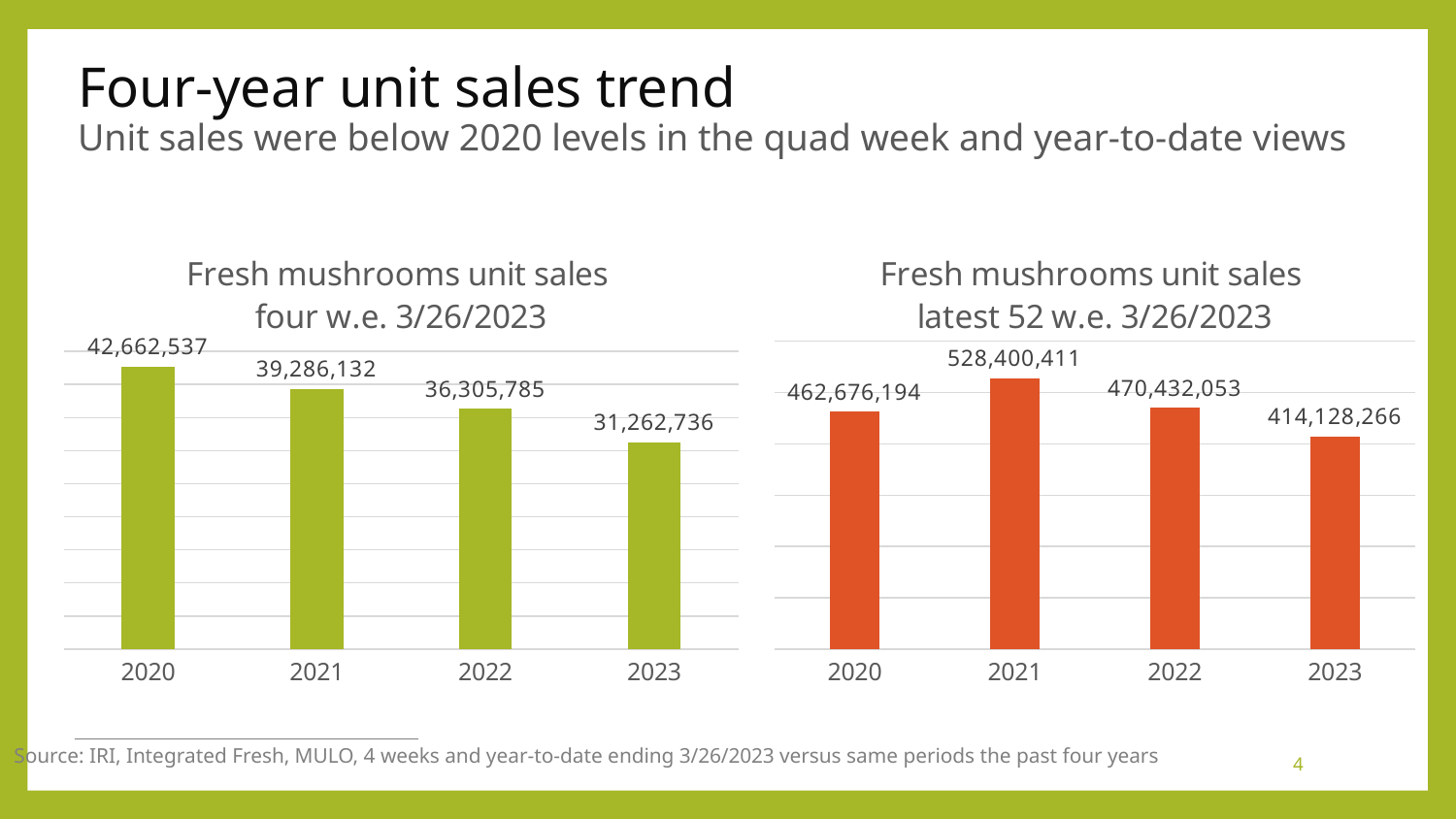
In the 'Fresh mushrooms unit sales latest 52 w.e. 3/26/2023' chart, what is the difference between the 2021 and 2023 values? 114,272,145 In the 'Fresh mushrooms unit sales four w.e. 3/26/2023' chart, which year has the highest value? 2020 In the 'Fresh mushrooms unit sales latest 52 w.e. 3/26/2023' chart, which is larger, the value for 2020 or the value for 2022? 2022 In the 'Fresh mushrooms unit sales four w.e. 3/26/2023' chart, what is the value for 2020? 42,662,537 In the 'Fresh mushrooms unit sales four w.e. 3/26/2023' chart, what is the value for 2023? 31,262,736 In the 'Fresh mushrooms unit sales latest 52 w.e. 3/26/2023' chart, what is the value for 2021? 528,400,411 What kind of chart is the 'Fresh mushrooms unit sales latest 52 w.e. 3/26/2023' chart? bar chart In the 'Fresh mushrooms unit sales latest 52 w.e. 3/26/2023' chart, which year has the highest value? 2021 In the 'Fresh mushrooms unit sales latest 52 w.e. 3/26/2023' chart, what is the value for 2022? 470,432,053 In the 'Fresh mushrooms unit sales four w.e. 3/26/2023' chart, do the values rise or fall from 2020 to 2023? fall In the 'Fresh mushrooms unit sales four w.e. 3/26/2023' chart, what is the difference between the 2020 and 2023 values? 11,399,801 In the 'Fresh mushrooms unit sales latest 52 w.e. 3/26/2023' chart, which year has the lowest value? 2023